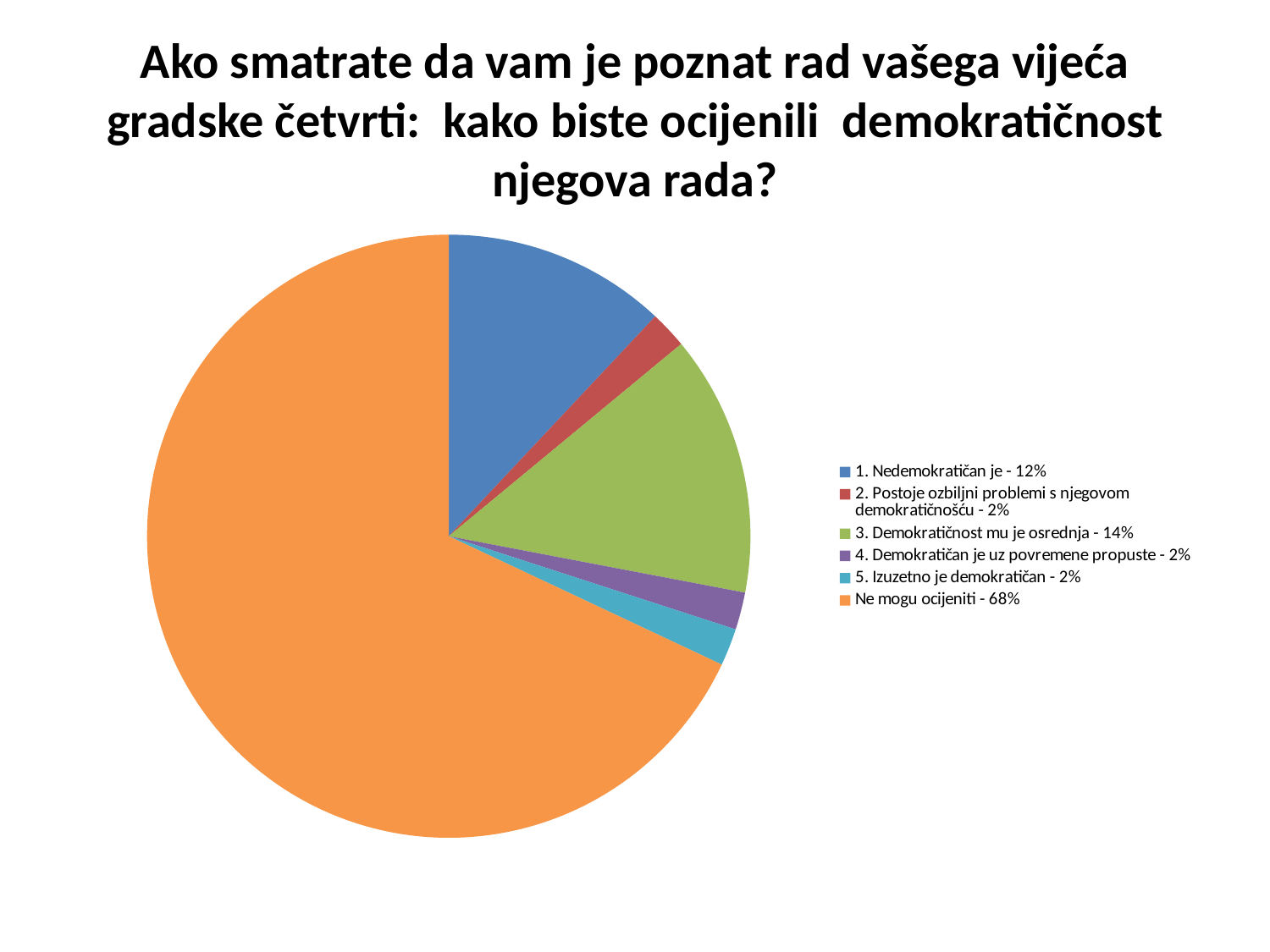
What share of the pie is "1. Nedemokratičan je"? 12% What is the difference between the shares of "1. Nedemokratičan je" and "2. Postoje ozbiljni problemi s njegovom demokratičnošću"? 10% What share of the pie is "3. Demokratičnost mu je osrednja"? 14% How many categories share the value 2% in the legend? 3 Which category has the largest slice of the pie? Ne mogu ocijeniti What share of the pie is "5. Izuzetno je demokratičan"? 2% How many slices does the pie chart have? 6 What is the difference between the shares of "Ne mogu ocijeniti" and "3. Demokratičnost mu je osrednja"? 54% What colour is the slice for "Ne mogu ocijeniti"? orange Which is larger: "1. Nedemokratičan je" or "3. Demokratičnost mu je osrednja"? 3. Demokratičnost mu je osrednja What kind of chart is shown on the slide? pie chart